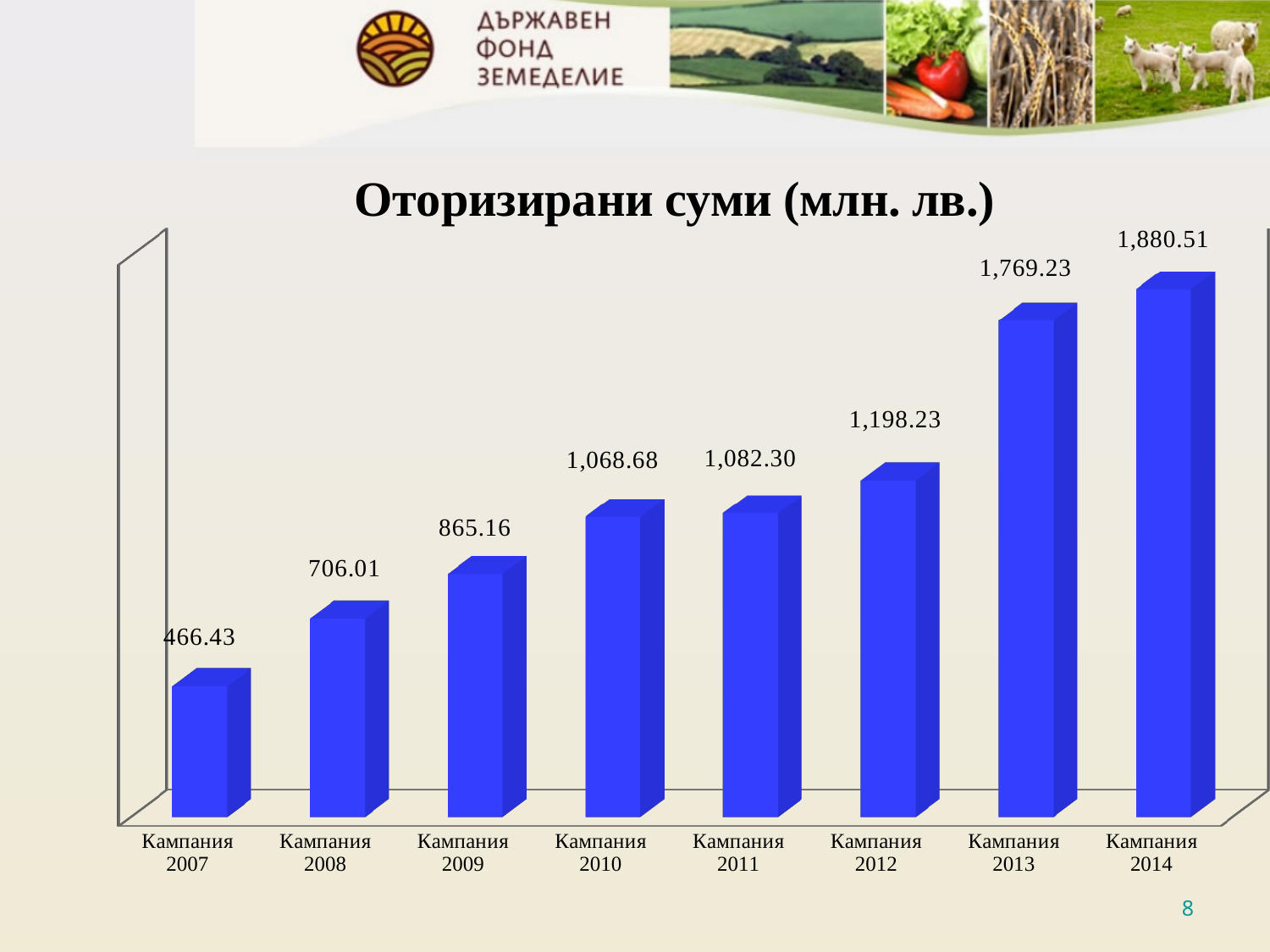
How many campaigns are shown on the chart? 8 What is the value for Кампания 2009? 865.16 Which campaign has the lowest value? Кампания 2007 What is the title of the chart? Оторизирани суми (млн. лв.) What is the difference between the values for Кампания 2008 and Кампания 2007? 239.58 Which campaign has the highest value? Кампания 2014 What is the value for Кампания 2012? 1,198.23 What is the value for Кампания 2007? 466.43 Do the values rise or fall from Кампания 2007 to Кампания 2014? Rise What is the difference between the values for Кампания 2014 and Кампания 2013? 111.28 What kind of chart is shown on the slide? Bar chart Which is larger, the value for Кампания 2010 or Кампания 2011? Кампания 2011